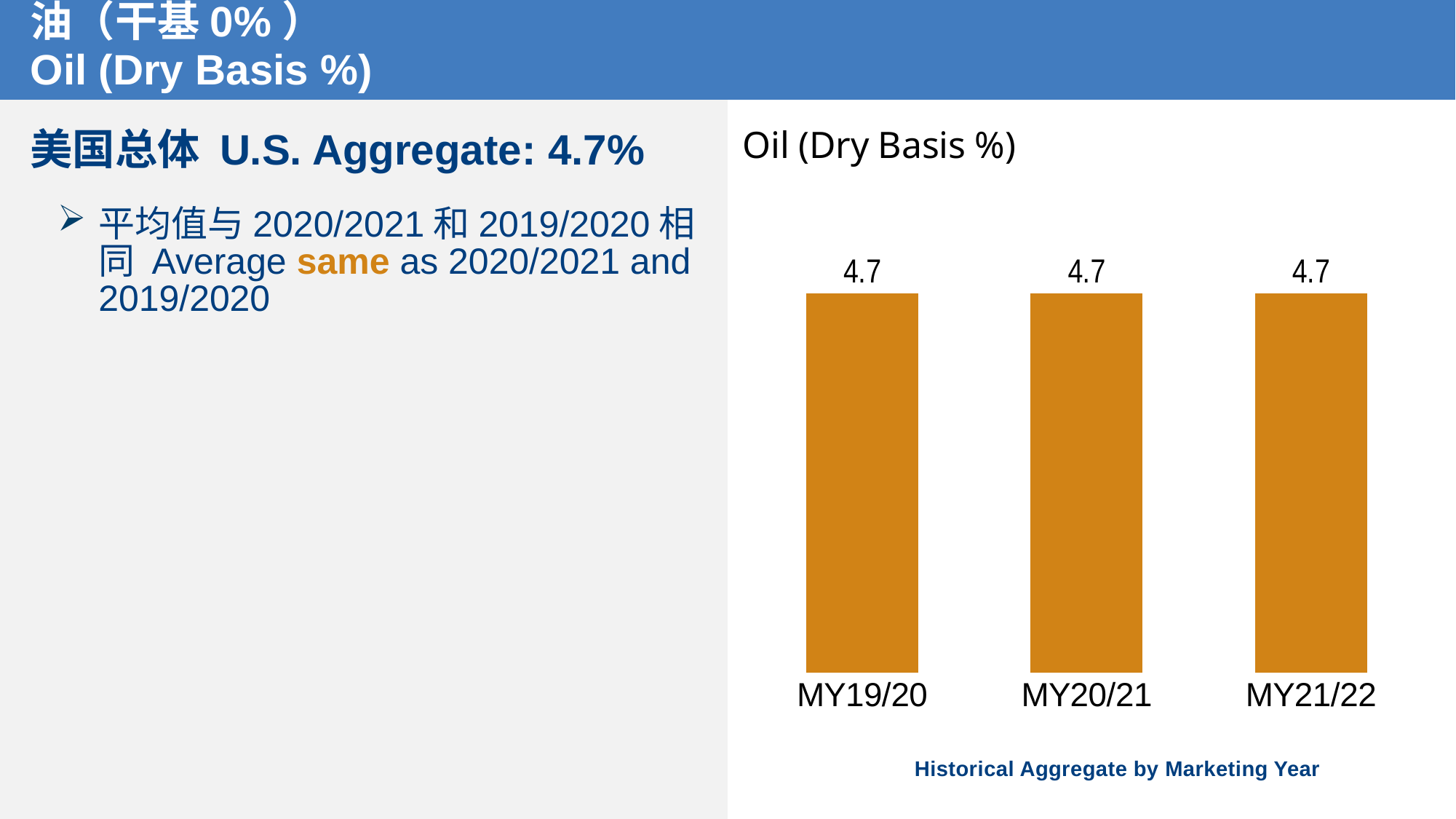
How many marketing years are shown on the chart? 3 Is the value for MY20/21 greater or less than 5? less What is the title of the chart? Oil (Dry Basis %) What is the difference between the values for MY21/22 and MY19/20? 0 What is the value for MY21/22? 4.7 Do the values rise, fall, or stay the same from MY19/20 to MY21/22? stay the same What is the value for MY19/20? 4.7 What kind of chart is shown on the slide? bar chart What is the value for MY20/21? 4.7 What colour are the bars in the chart? orange